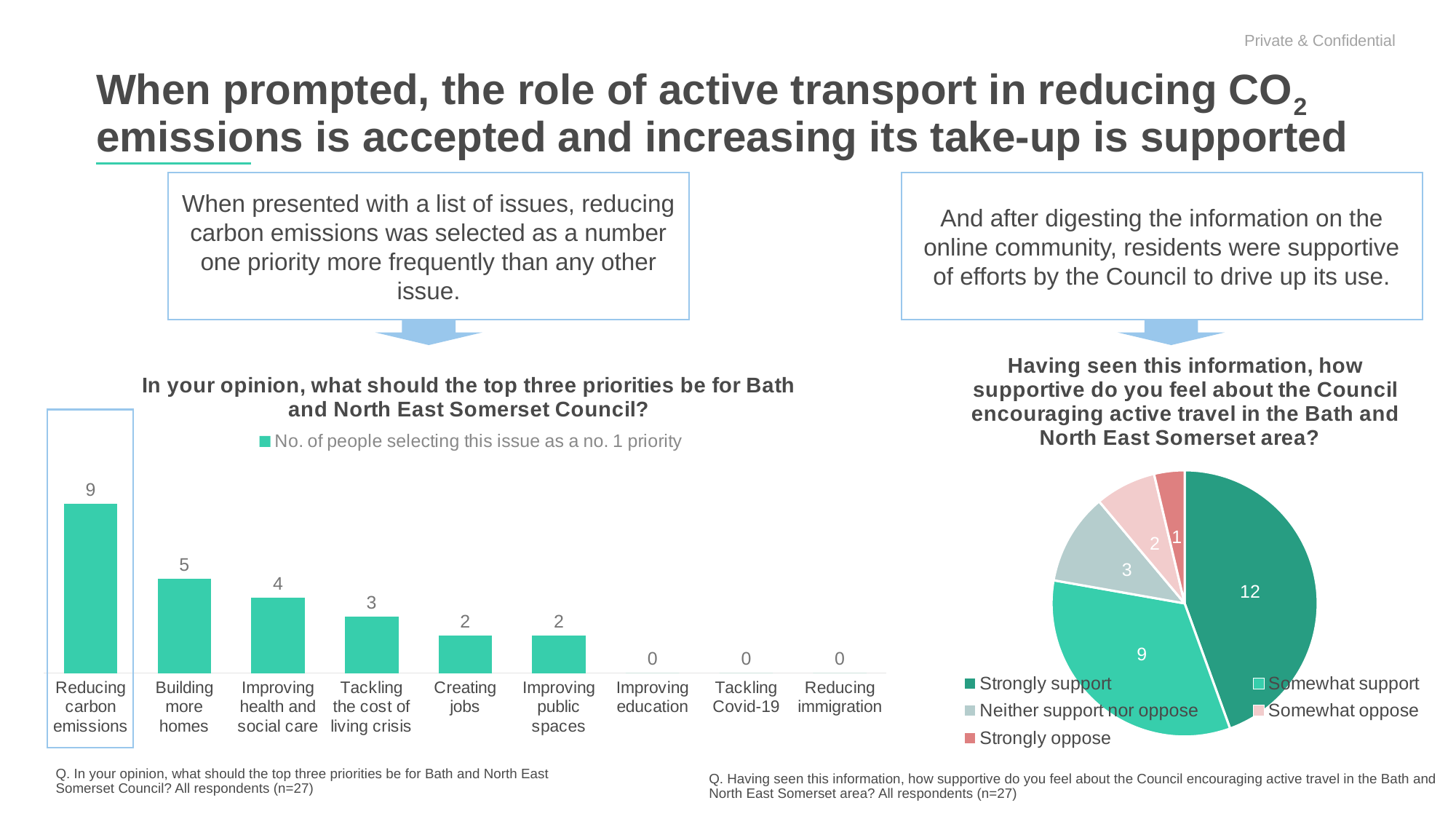
How many response categories does the legend of the pie chart on the right list? 5 In the bar chart on the left, which is larger: the value for Improving health and social care or the value for Tackling the cost of living crisis? Improving health and social care In the pie chart on the right, what is the difference between the Somewhat support and Neither support nor oppose values? 6 In the bar chart on the left, how many people selected reducing carbon emissions as a no. 1 priority? 9 How many issue categories are shown in the bar chart on the left? 9 What type of chart is the chart on the left of the slide? Bar chart In the bar chart on the left, how many issues have a value of 0? 3 In the bar chart on the left, what is the value for Building more homes? 5 In the bar chart on the left, what is the difference between the values for Reducing carbon emissions and Building more homes? 4 In the pie chart on the right, how many respondents said they strongly support the Council encouraging active travel? 12 In the bar chart on the left, which issue has the highest number of people selecting it as a no. 1 priority? Reducing carbon emissions In the pie chart on the right, which response has the smallest slice? Strongly oppose